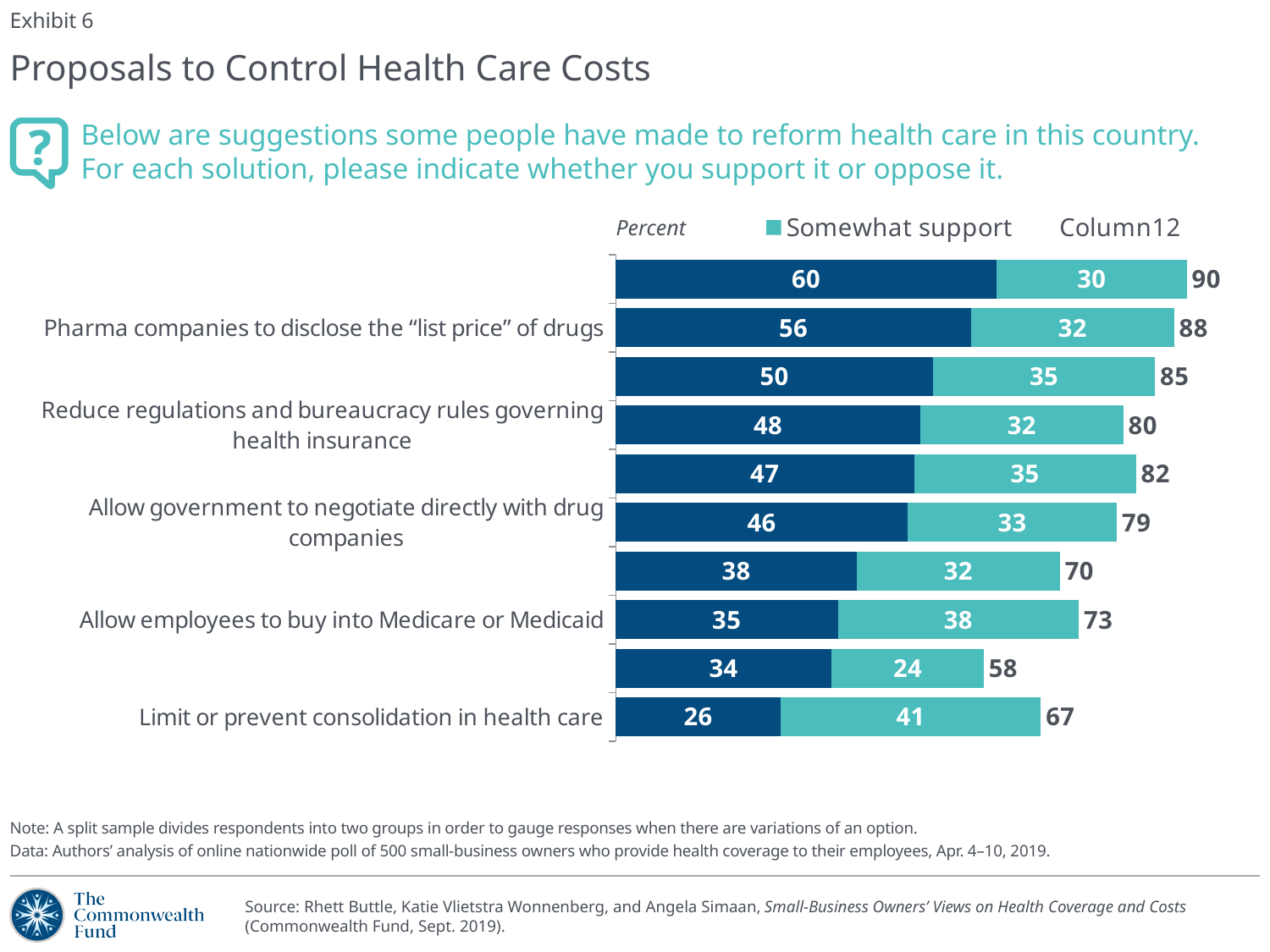
What is the total shown at the end of the bar for "Reduce regulations and bureaucracy rules governing health insurance"? 80 What is the "Somewhat support" value for "Allow employees to buy into Medicare or Medicaid"? 38 What kind of chart is shown on the slide? Stacked bar chart What is the "Somewhat support" value for "Limit or prevent consolidation in health care"? 41 What is the "Somewhat support" value for "Pharma companies to disclose the "list price" of drugs"? 32 What is the difference between the totals for "Pharma companies to disclose the "list price" of drugs" and "Limit or prevent consolidation in health care"? 21 Which has the larger "Somewhat support" value: "Limit or prevent consolidation in health care" or "Pharma companies to disclose the "list price" of drugs"? Limit or prevent consolidation in health care What is the total shown at the end of the bar for "Limit or prevent consolidation in health care"? 67 What is the total shown at the end of the bar for "Allow government to negotiate directly with drug companies"? 79 Of the proposals whose labels are shown on the slide, which has the highest total? Pharma companies to disclose the "list price" of drugs Of the proposals whose labels are shown on the slide, which has the lowest total? Limit or prevent consolidation in health care